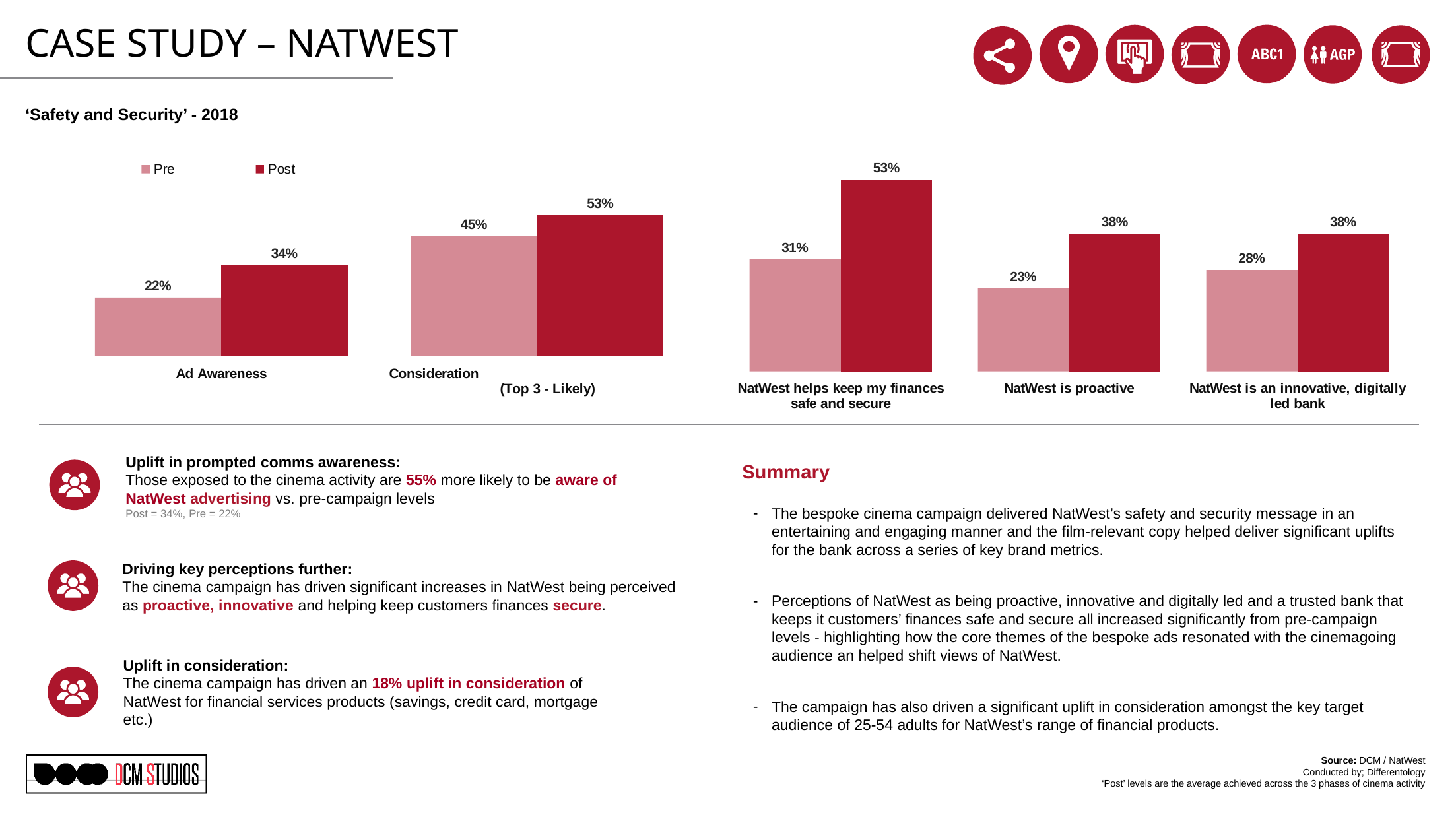
In the right chart, what is the Post value for 'NatWest helps keep my finances safe and secure'? 53% In the left chart, how many series does the legend list? 2 In the right chart, what is the difference between the Post and Pre values for 'NatWest is proactive'? 15% In the right chart, how many categories are shown? 3 In the left chart, what is the Pre value for Consideration (Top 3 - Likely)? 45% In the right chart, which category has the lowest Pre value? NatWest is proactive In the right chart, which category has the highest Post value? NatWest helps keep my finances safe and secure What kind of chart is the left chart? Bar chart In the right chart, is the Pre value for 'NatWest is an innovative, digitally led bank' larger or smaller than the Pre value for 'NatWest helps keep my finances safe and secure'? Smaller In the left chart, what is the difference between the Post and Pre values for Ad Awareness? 12% In the right chart, what is the Pre value for 'NatWest is proactive'? 23% In the left chart, what is the Post value for Ad Awareness? 34%